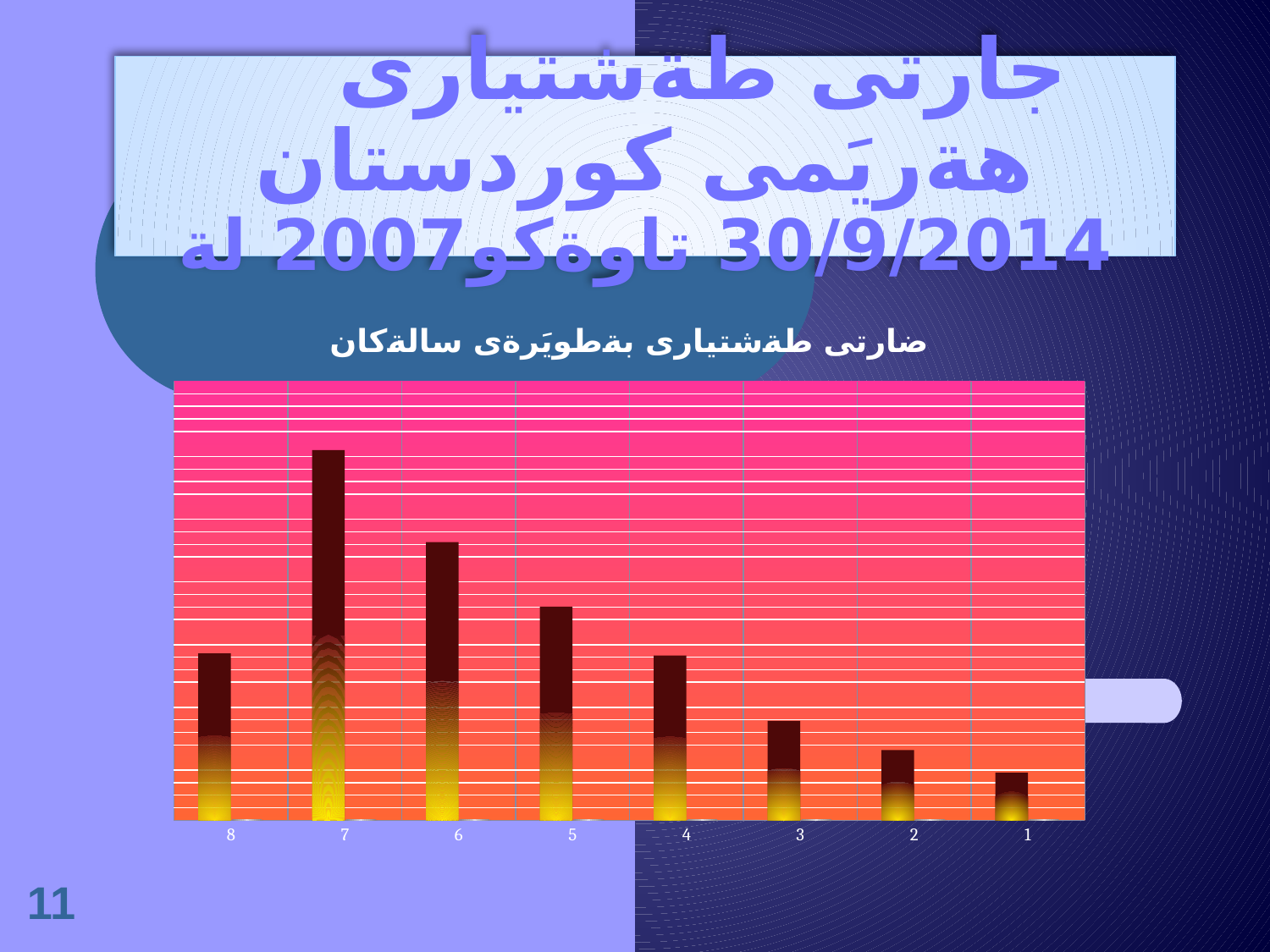
Which bar is taller, category 8 or category 5? 5 Which bar is taller, category 6 or category 4? 6 Which bar is taller, category 2 or category 1? 2 Which category has the lowest bar in the chart? 1 Which category is the second highest bar in the chart? 6 Which category has the highest bar in the chart? 7 What are the x-axis category labels of the chart, from left to right? 8, 7, 6, 5, 4, 3, 2, 1 Do the bar values rise or fall moving from category 7 to category 1 along the x axis? fall What kind of chart is shown on the slide? bar chart How many categories are shown on the x axis of the chart? 8